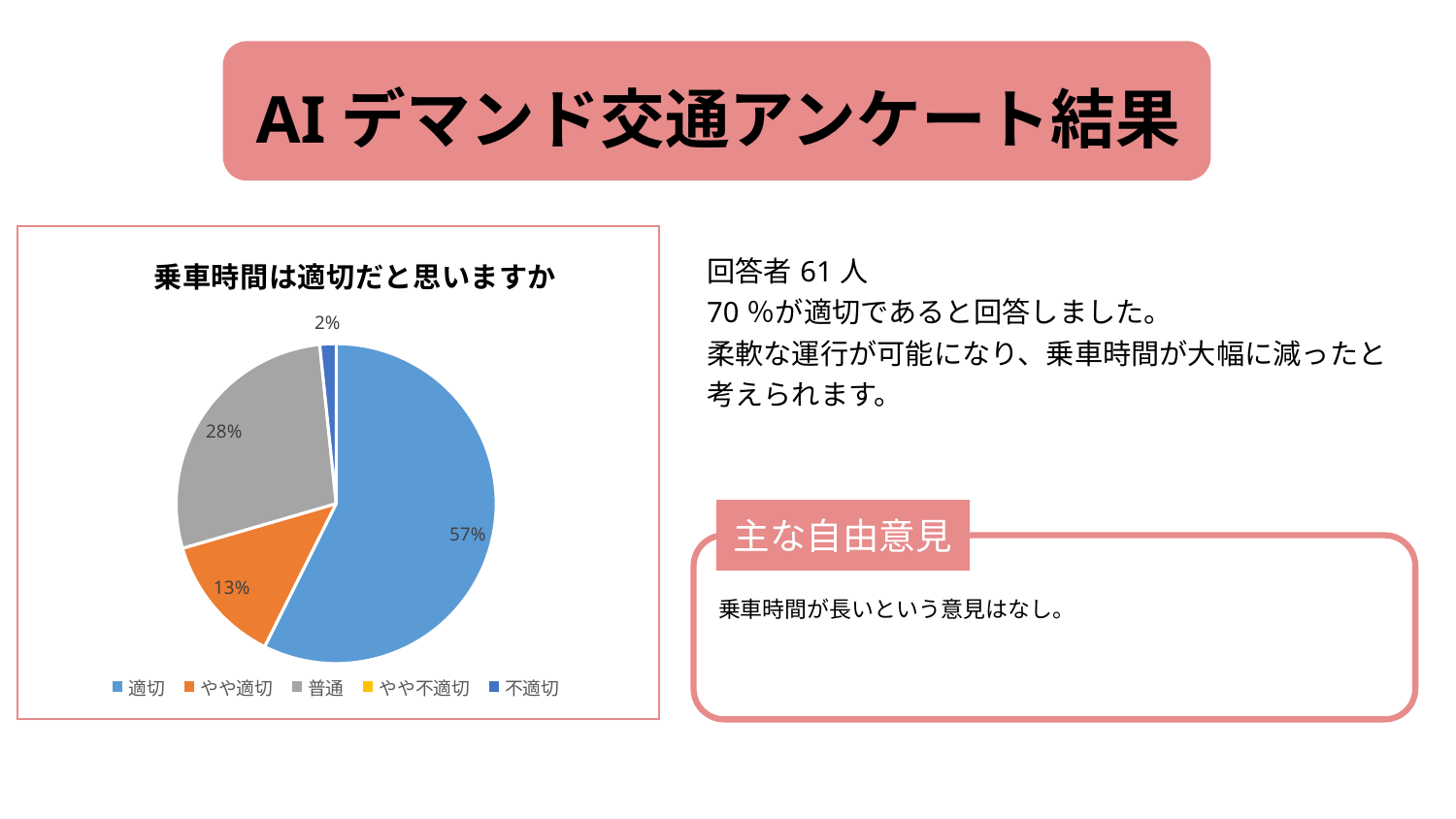
Which is larger, the share for 普通 or the share for やや適切? 普通 What percentage of respondents answered 適切? 57% What percentage of respondents answered やや適切? 13% What is the difference in percentage points between the 適切 slice and the 普通 slice? 29 percentage points What percentage of respondents answered 普通? 28% What percentage of respondents answered 不適切? 2% What is the title of the pie chart? 乗車時間は適切だと思いますか What kind of chart is shown on the slide? pie chart What colour is the 適切 slice of the pie chart? blue Which labelled category has the smallest slice of the pie? 不適切 Which category has the largest slice of the pie? 適切 How many categories does the legend of the pie chart list? 5